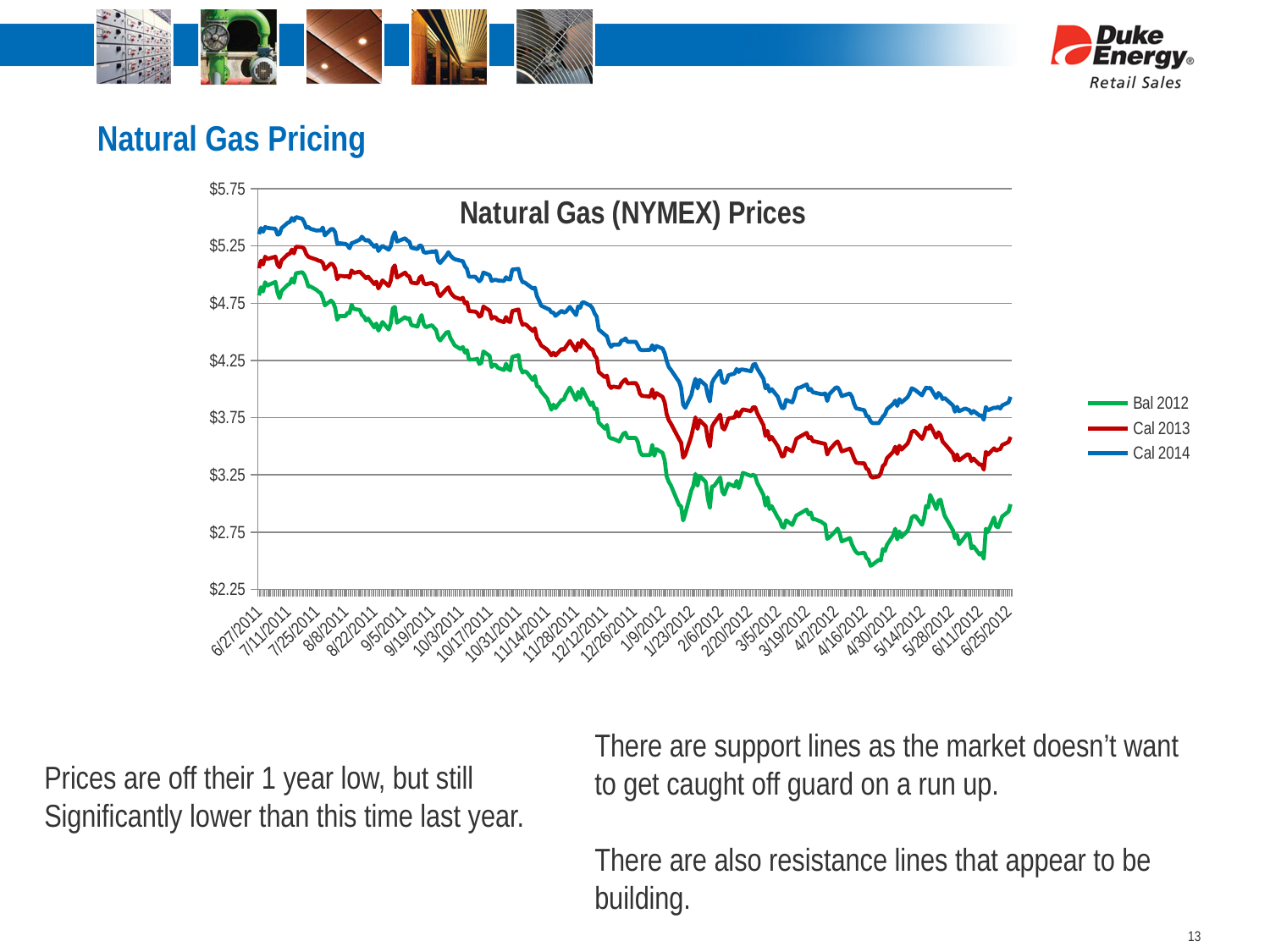
Do the Bal 2012 prices generally rise or fall from 6/27/2011 to 6/25/2012? fall Is the Bal 2012 value at 6/25/2012 greater or less than $3.25? less Which series has the highest prices across the whole period shown? Cal 2014 Is the Cal 2014 value at 6/27/2011 greater or less than $5.25? greater What kind of chart is shown on the slide? line chart How many series does the chart's legend list? 3 Is the Cal 2014 value at 6/25/2012 greater or less than $4.25? less Which series is drawn in green? Bal 2012 Which series has the lowest prices across the whole period shown? Bal 2012 At 1/23/2012, which is larger, the Cal 2014 value or the Bal 2012 value? Cal 2014 What is the title of the chart? Natural Gas (NYMEX) Prices